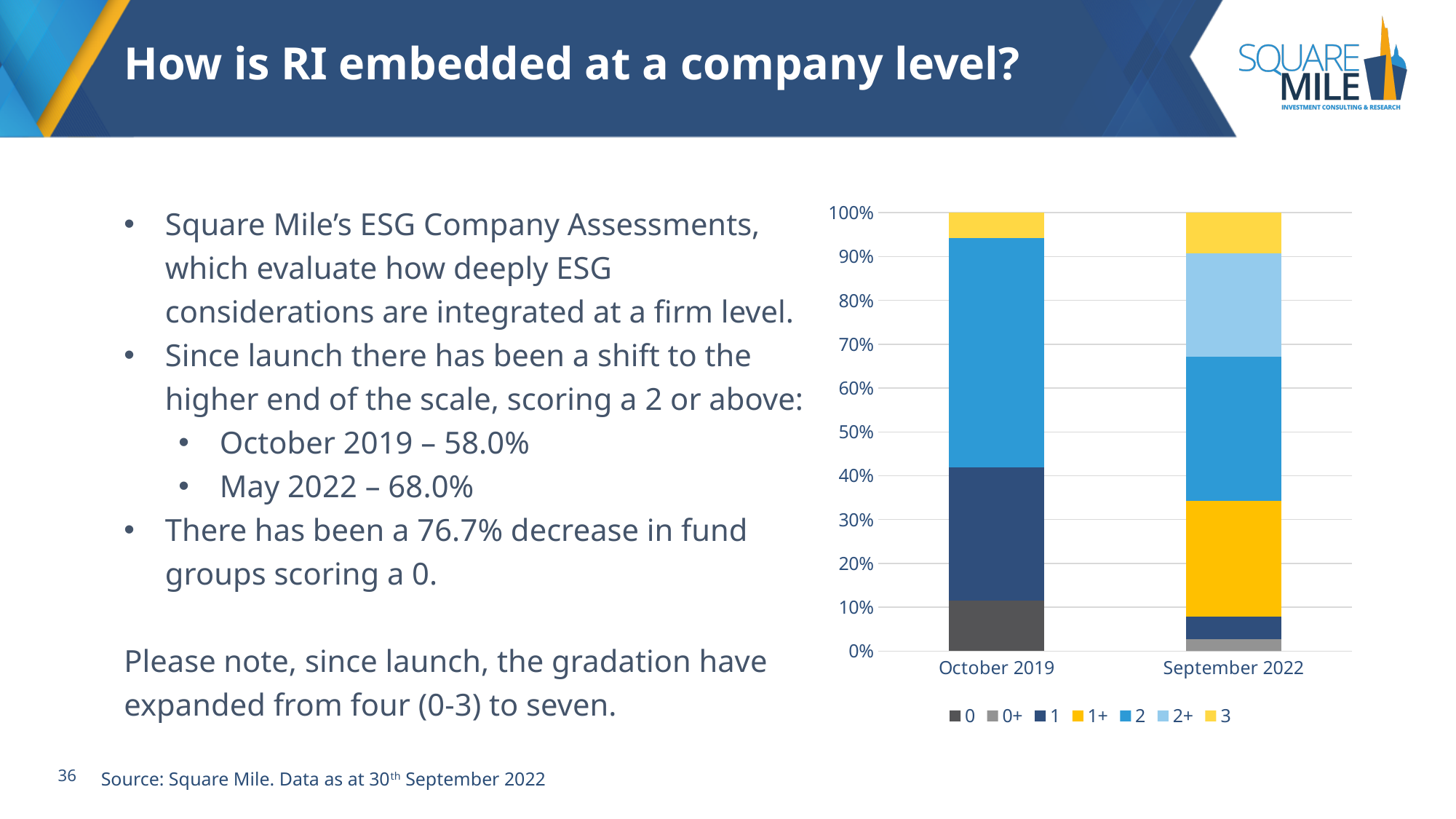
Which bar has the larger '0' segment, October 2019 or September 2022? October 2019 Is the share of the '1+' segment in the September 2022 bar greater or less than 10%? greater What does each stacked bar in the chart total? 100% Is the share of the '0' segment in the October 2019 bar greater or less than 20%? less Which bar has the larger '1' segment, October 2019 or September 2022? October 2019 What kind of chart is shown on the slide? Stacked bar chart Is the share of the '1' segment in the October 2019 bar greater or less than 20%? greater What are the two categories on the x axis of the chart? October 2019 and September 2022 How many series does the chart legend list? 7 How many categories are shown on the x axis of the chart? 2 What are the legend entries of the chart, in order? 0, 0+, 1, 1+, 2, 2+, 3